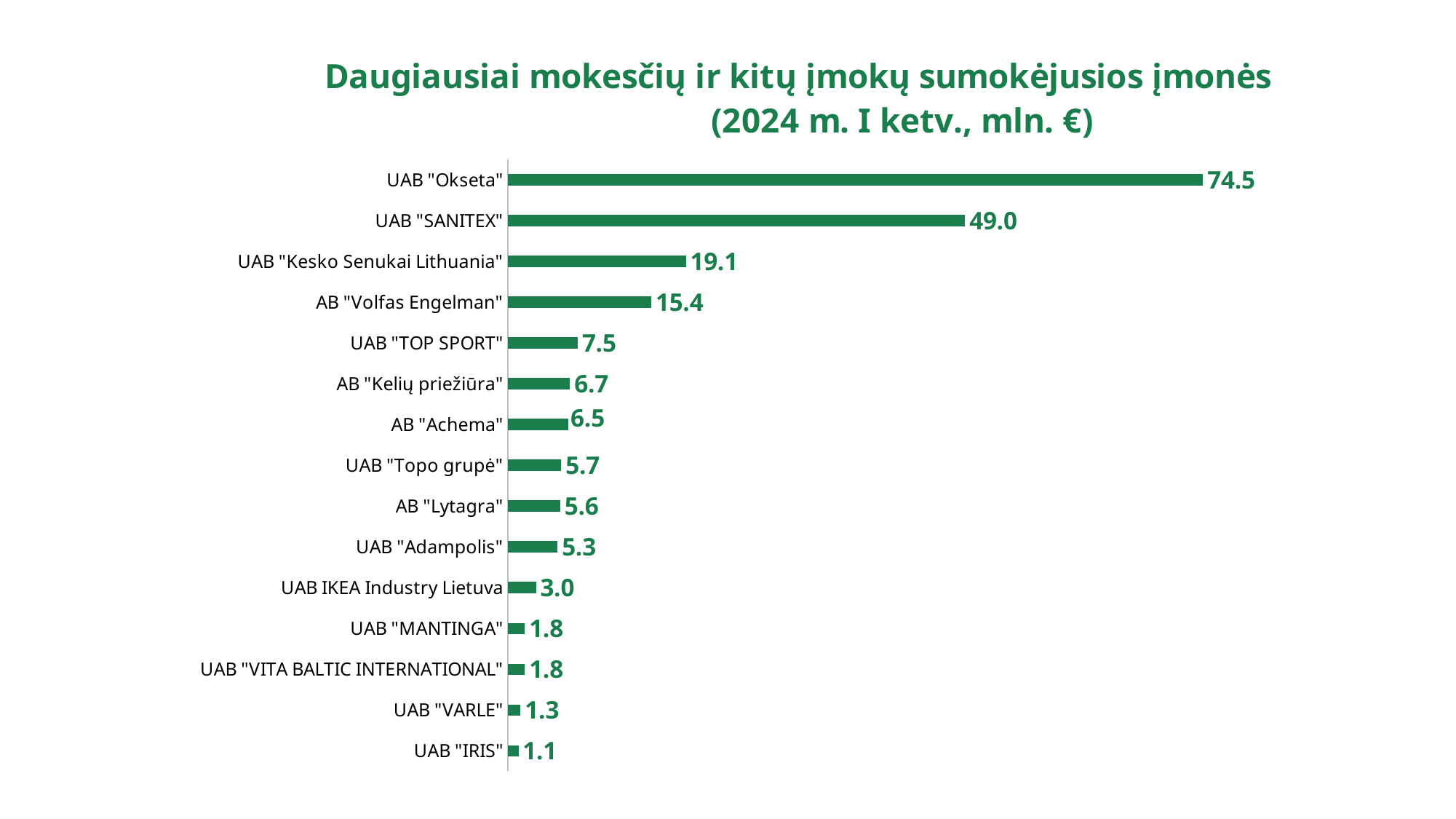
What is the value for UAB "Okseta"? 74.5 Which company has the lowest value? UAB "IRIS" What is the difference between the values for UAB "Kesko Senukai Lithuania" and AB "Volfas Engelman"? 3.7 What kind of chart is this? Bar chart What is the value for AB "Volfas Engelman"? 15.4 What is the difference between the values for UAB "Okseta" and UAB "SANITEX"? 25.5 What is the value for UAB "VARLE"? 1.3 What is the title of the chart? Daugiausiai mokesčių ir kitų įmokų sumokėjusios įmonės (2024 m. I ketv., mln. €) Which company has the highest value? UAB "Okseta" How many companies are shown in the chart? 15 Which is larger, the value for UAB "TOP SPORT" or the value for AB "Achema"? UAB "TOP SPORT" What is the value for UAB IKEA Industry Lietuva? 3.0